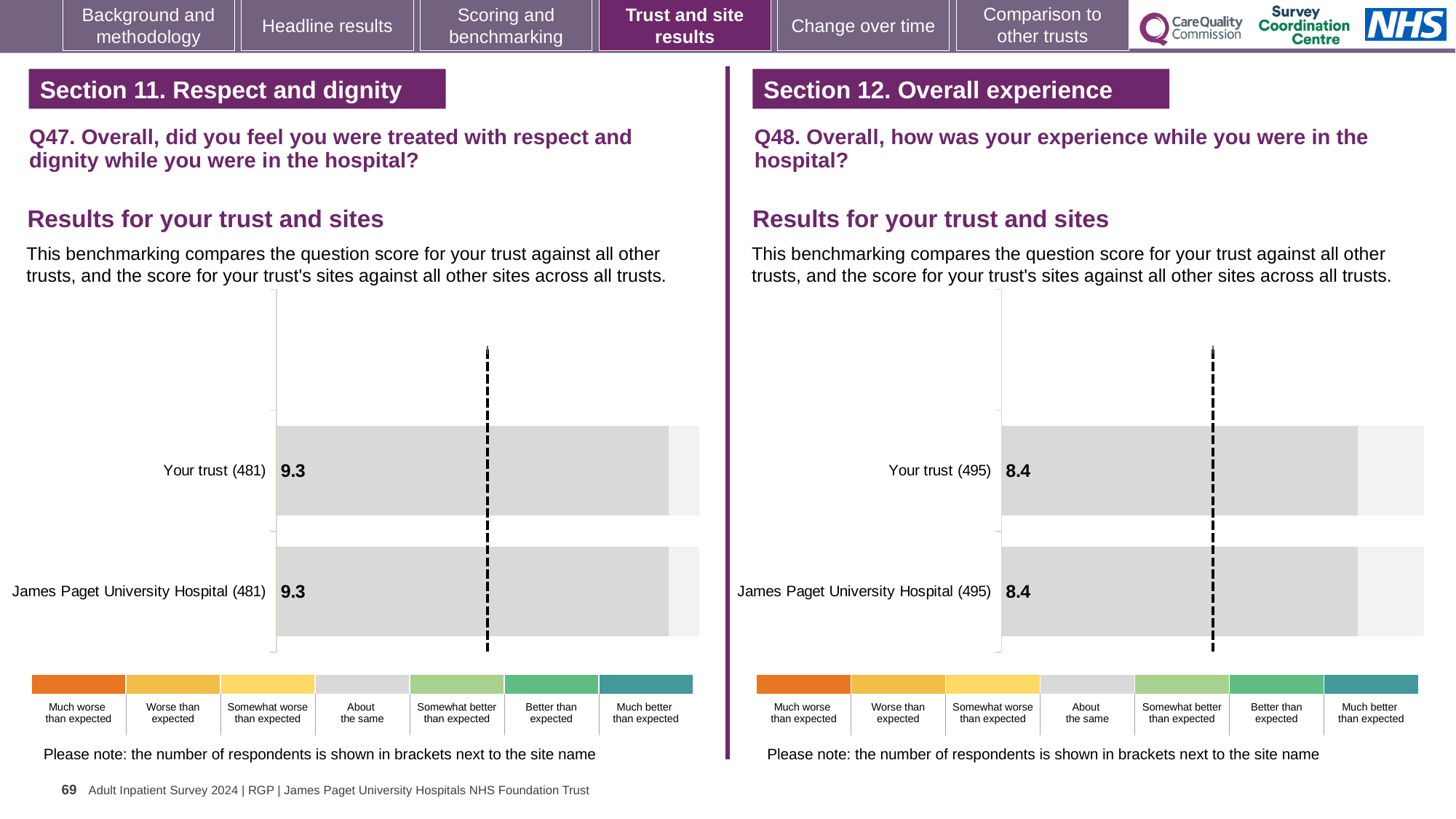
In the Q48 chart on the right, how many respondents are shown in brackets next to James Paget University Hospital? 495 In the Q48 chart on the right, what is the score for James Paget University Hospital? 8.4 How many bars are plotted in the Q48 chart on the right? 2 How many bars are plotted in the Q47 chart on the left? 2 In the Q48 chart on the right, what is the score for Your trust? 8.4 In the Q47 chart on the left, how many respondents are shown in brackets next to Your trust? 481 In the Q47 chart on the left, what is the difference between the score for Your trust and the score for James Paget University Hospital? 0 In the Q47 chart on the left, what is the score for Your trust? 9.3 What kind of chart is used for the Q47 results on the left? Bar chart Is the score for Your trust in the Q47 chart on the left larger than, smaller than, or equal to the score for Your trust in the Q48 chart on the right? Larger In the Q47 chart on the left, what is the score for James Paget University Hospital? 9.3 In the Q48 chart on the right, what is the difference between the score for Your trust and the score for James Paget University Hospital? 0